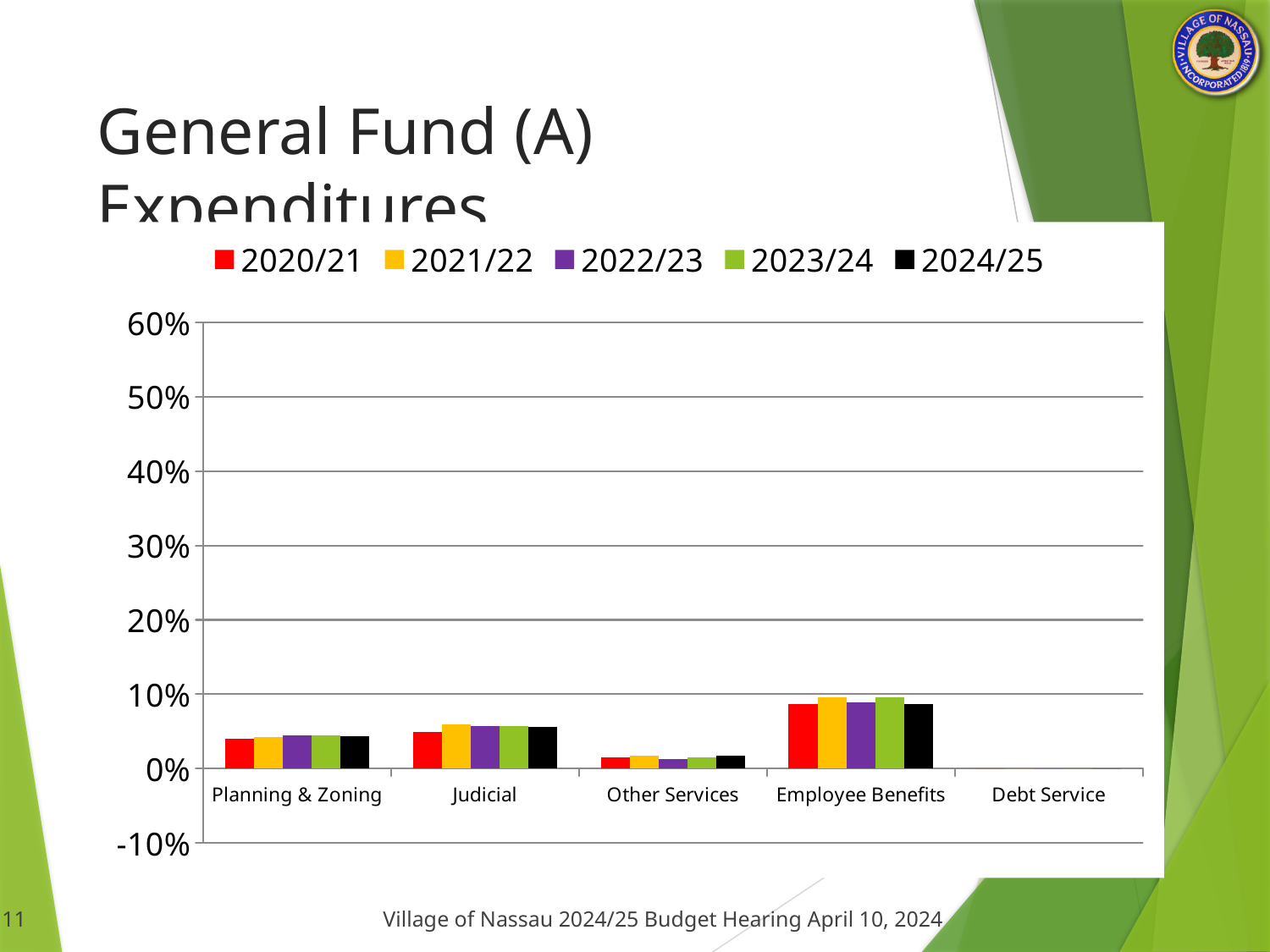
Is the value for Employee Benefits in 2020/21 greater or less than 10%? less Which series is shown in black in the chart legend? 2024/25 Which is larger for 2021/22: Judicial or Planning & Zoning? Judicial What kind of chart is shown on the slide? bar chart Which category has the lowest values in the chart? Debt Service What is the title of the chart on the slide? General Fund (A) Expenditures Which is larger for 2021/22: Employee Benefits or Other Services? Employee Benefits How many categories are shown on the x axis of the chart? 5 How many series does the chart legend list? 5 Is the value for Other Services in 2024/25 greater or less than 10%? less Which category has the highest bars in the chart? Employee Benefits Is the value for Judicial in 2021/22 greater or less than 10%? less